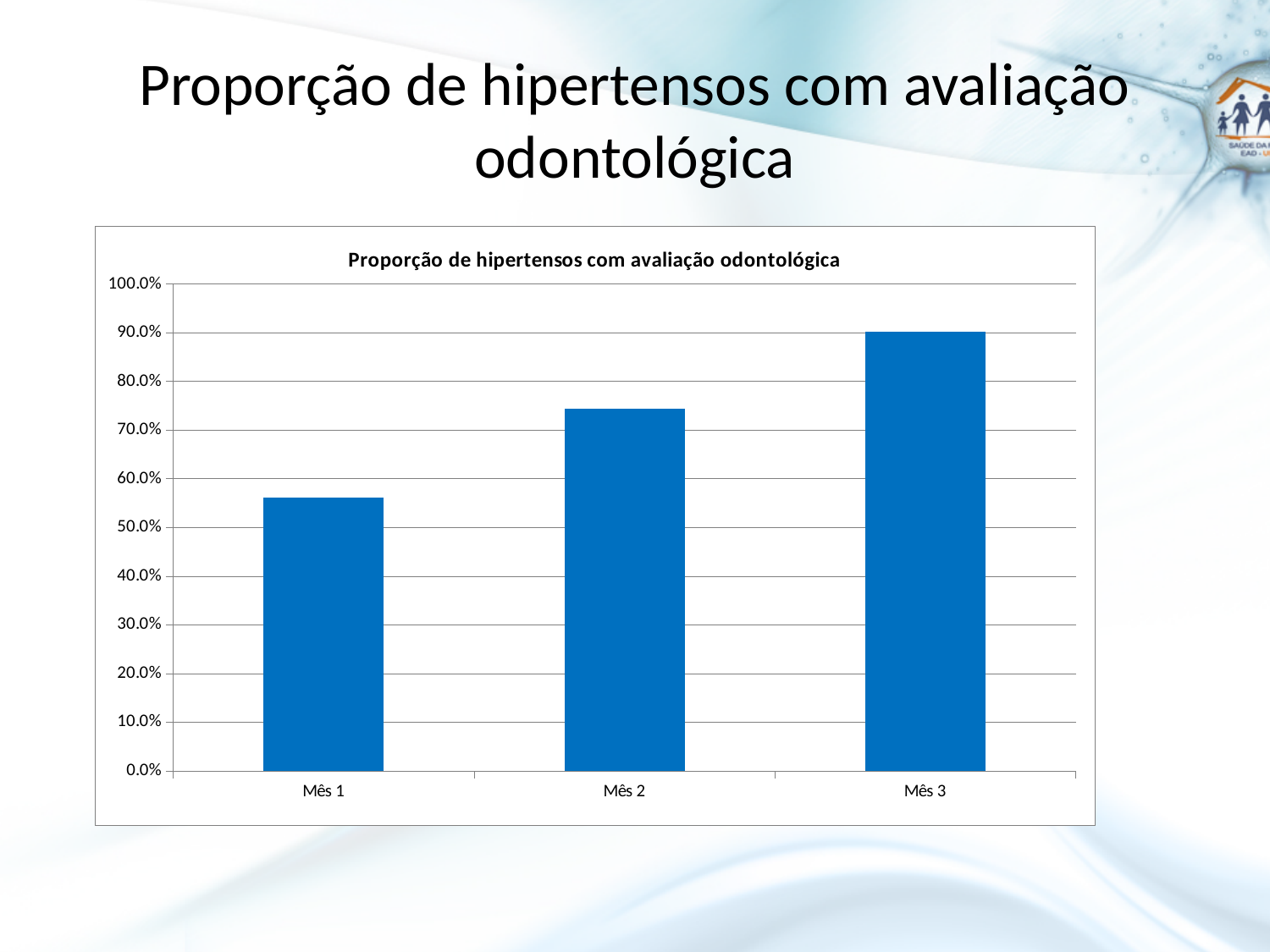
Is the value for Mês 1 greater or less than 50.0%? greater Is the value for Mês 1 greater or less than 60.0%? less Which month has the lowest proportion of hypertensive patients with dental evaluation? Mês 1 Is the value for Mês 2 greater or less than 80.0%? less Do the values rise or fall from Mês 1 to Mês 3? rise Which month has the highest proportion of hypertensive patients with dental evaluation? Mês 3 What kind of chart is shown on the slide? bar chart What is the title of the chart? Proporção de hipertensos com avaliação odontológica How many categories are plotted on the x axis? 3 Which is larger, the value for Mês 1 or the value for Mês 2? Mês 2